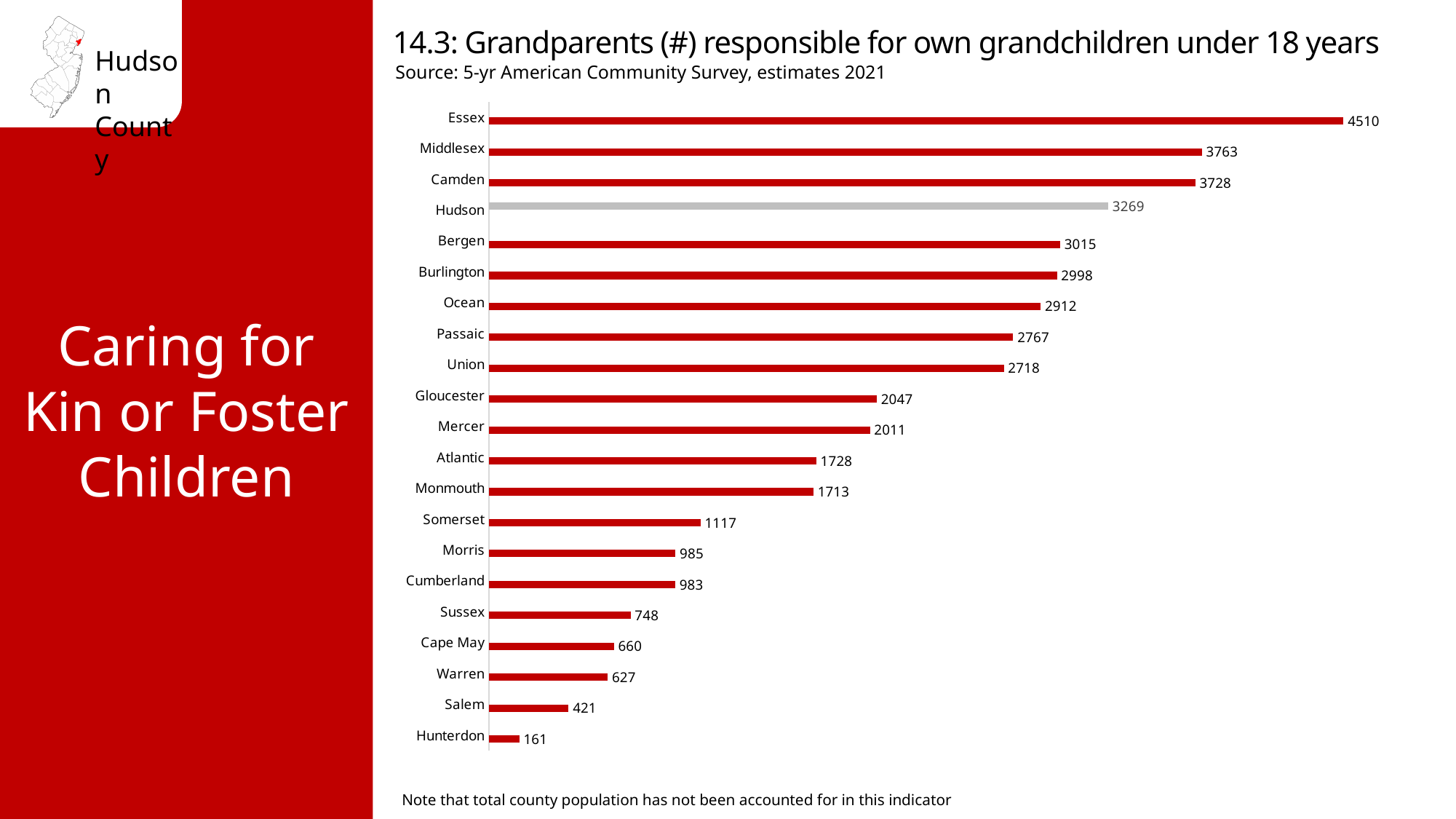
Which is larger, the value for Bergen or the value for Union? Bergen Which county's bar is shown in grey rather than red? Hudson What is the difference between the values for Middlesex and Camden? 35 What is the value for Hunterdon? 161 Which county has the highest value? Essex What kind of chart is shown on the slide? Bar chart Which county has the lowest value? Hunterdon What is the difference between the values for Essex and Hudson? 1241 What is the value for Hudson? 3269 What is the value for Essex? 4510 How many counties are shown in the chart? 21 What is the source given for the chart data? 5-yr American Community Survey, estimates 2021